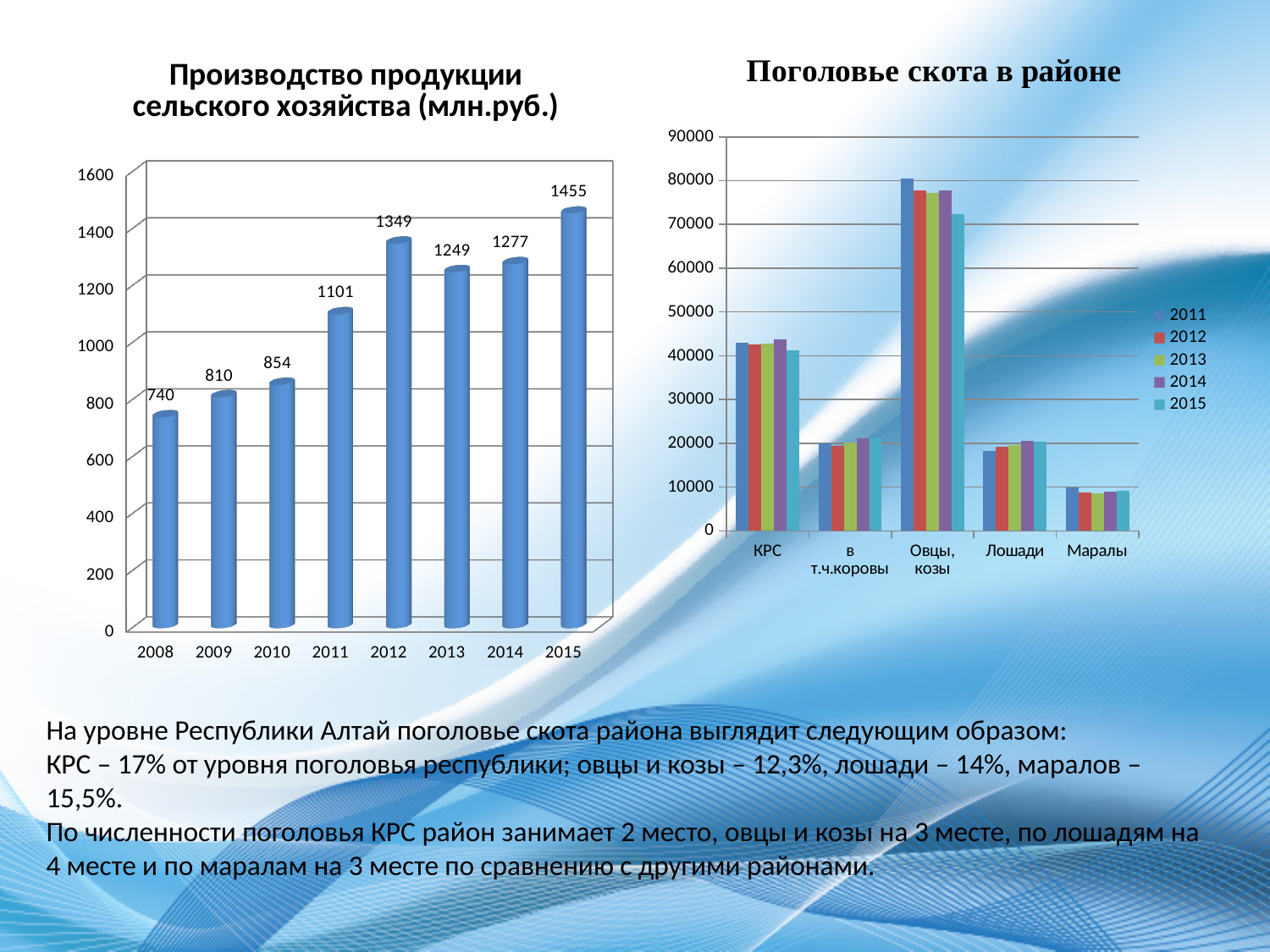
In the chart 'Производство продукции сельского хозяйства (млн.руб.)', which year has the highest value? 2015 In the chart 'Поголовье скота в районе', is the value for Маралы in 2012 greater or less than 10000? less How many series does the legend of the chart 'Поголовье скота в районе' list? 5 In the chart 'Поголовье скота в районе', is the value for Овцы, козы in 2011 greater or less than 70000? greater How many years are shown on the x axis of the chart 'Производство продукции сельского хозяйства (млн.руб.)'? 8 What kind of chart is 'Поголовье скота в районе'? bar chart In the chart 'Поголовье скота в районе', which category has the highest values? Овцы, козы In the chart 'Производство продукции сельского хозяйства (млн.руб.)', what is the value for 2015? 1455 In the chart 'Производство продукции сельского хозяйства (млн.руб.)', which year has the lowest value? 2008 In the chart 'Производство продукции сельского хозяйства (млн.руб.)', what is the value for 2011? 1101 In the chart 'Производство продукции сельского хозяйства (млн.руб.)', what is the difference between the values for 2012 and 2013? 100 In the chart 'Производство продукции сельского хозяйства (млн.руб.)', which is larger, the value for 2013 or the value for 2014? 2014